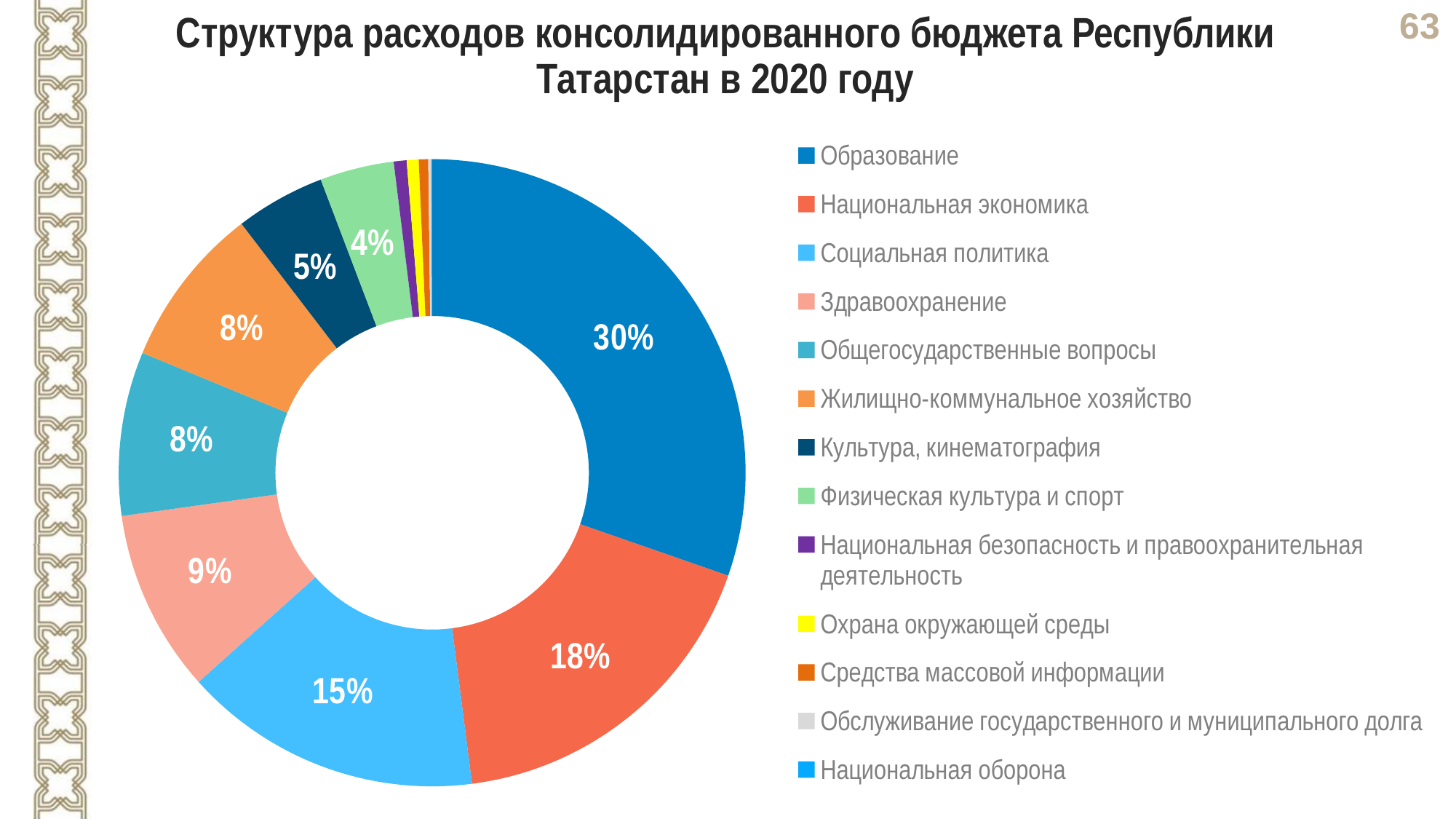
How many categories does the legend list? 13 What type of chart is shown on the slide? Pie (doughnut) chart Which category has the largest share of the budget expenditures? Образование What percentage is shown for Национальная экономика? 18% What share of expenditures does Образование account for? 30% What is the value for Физическая культура и спорт? 4% What is the title of the chart? Структура расходов консолидированного бюджета Республики Татарстан в 2020 году Which is larger, the share for Социальная политика or the share for Здравоохранение? Социальная политика What is the difference in percentage points between Образование and Национальная экономика? 12 What is the value for Социальная политика? 15% What percentage is shown for Культура, кинематография? 5% What share is labelled for Здравоохранение? 9%